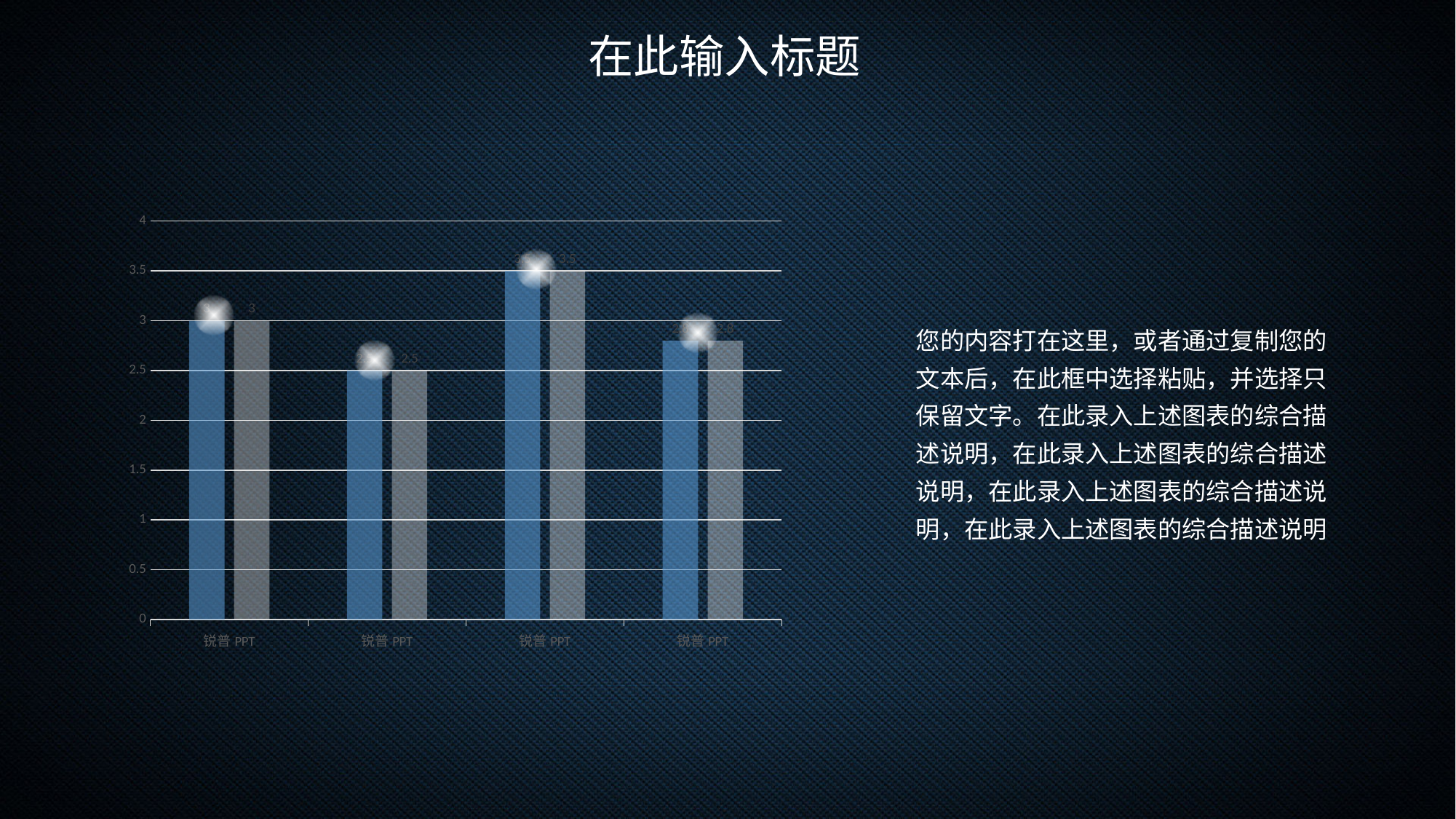
Which is larger, the value of the first category or the value of the second category? the first category Is the value for the fourth (rightmost) category greater or less than 2.5? greater Which category has the lowest value in the chart? the second category What is the value labelled on the first (leftmost) category of the chart? 3 What kind of chart is shown on the slide? bar chart What label is shown under each category on the x axis of the chart? 锐普 PPT What is the difference between the value of the third category and the value of the first category? 0.5 How many categories are shown on the x axis of the chart? 4 What is the value labelled on the third category of the chart? 3.5 What is the value labelled on the second category of the chart? 2.5 Is the value for the fourth (rightmost) category greater or less than 3? less Which category has the highest value in the chart? the third category